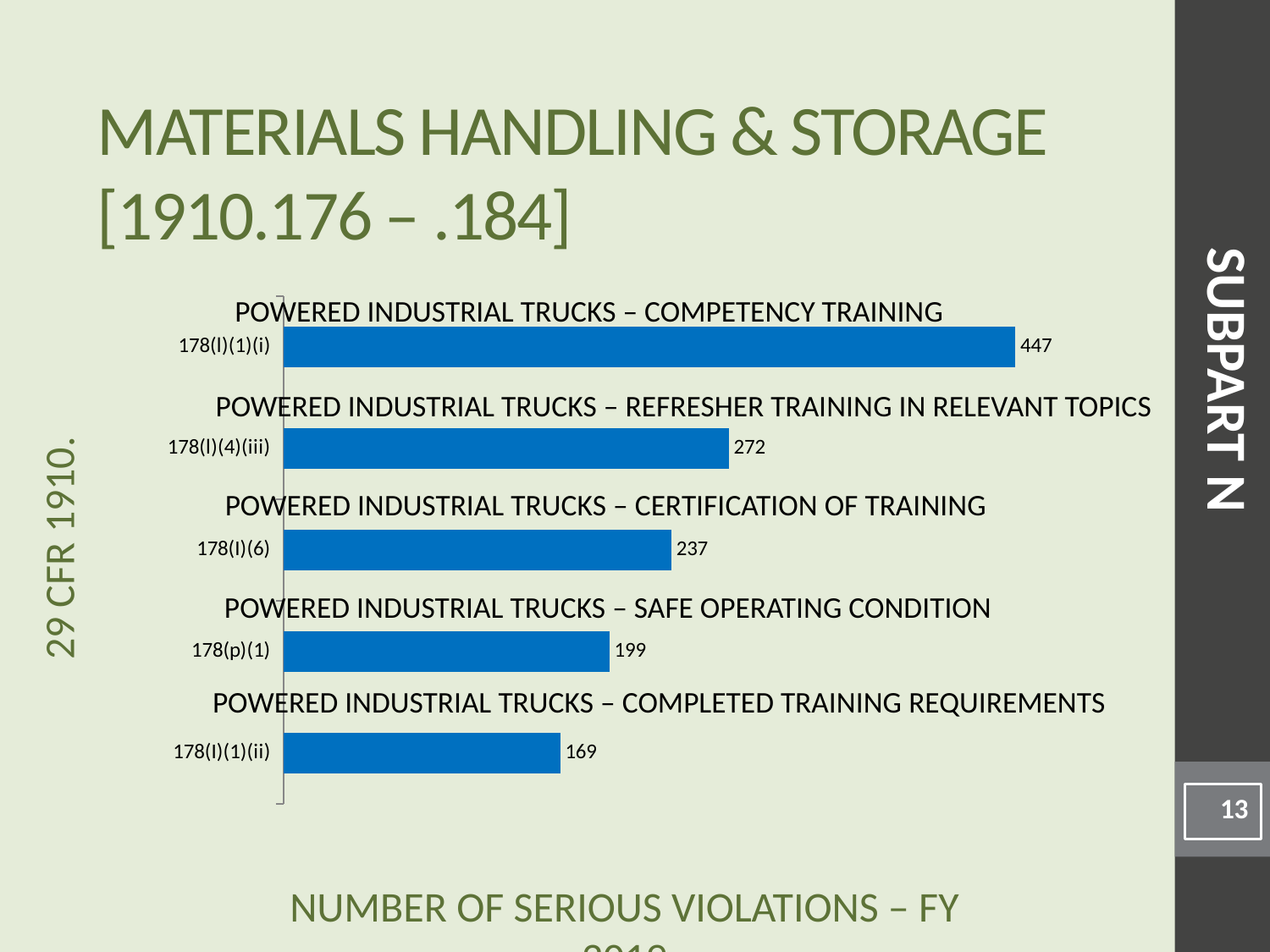
What is the number of serious violations for 178(l)(1)(i), Powered Industrial Trucks – Competency Training? 447 What is the number of serious violations for 178(l)(4)(iii), Powered Industrial Trucks – Refresher Training in Relevant Topics? 272 What is the difference in serious violations between 178(p)(1) and 178(l)(1)(ii)? 30 Which standard has the lowest number of serious violations? 178(l)(1)(ii) What is the number of serious violations for 178(l)(6), Powered Industrial Trucks – Certification of Training? 237 Which standard has the highest number of serious violations? 178(l)(1)(i) What is the number of serious violations for 178(p)(1), Powered Industrial Trucks – Safe Operating Condition? 199 What is the number of serious violations for 178(l)(1)(ii), Powered Industrial Trucks – Completed Training Requirements? 169 What is the difference in serious violations between 178(l)(1)(i) and 178(l)(4)(iii)? 175 Which has more serious violations, 178(l)(6) or 178(p)(1)? 178(l)(6) How many standards are shown in the chart? 5 What kind of chart is shown on the slide? Bar chart